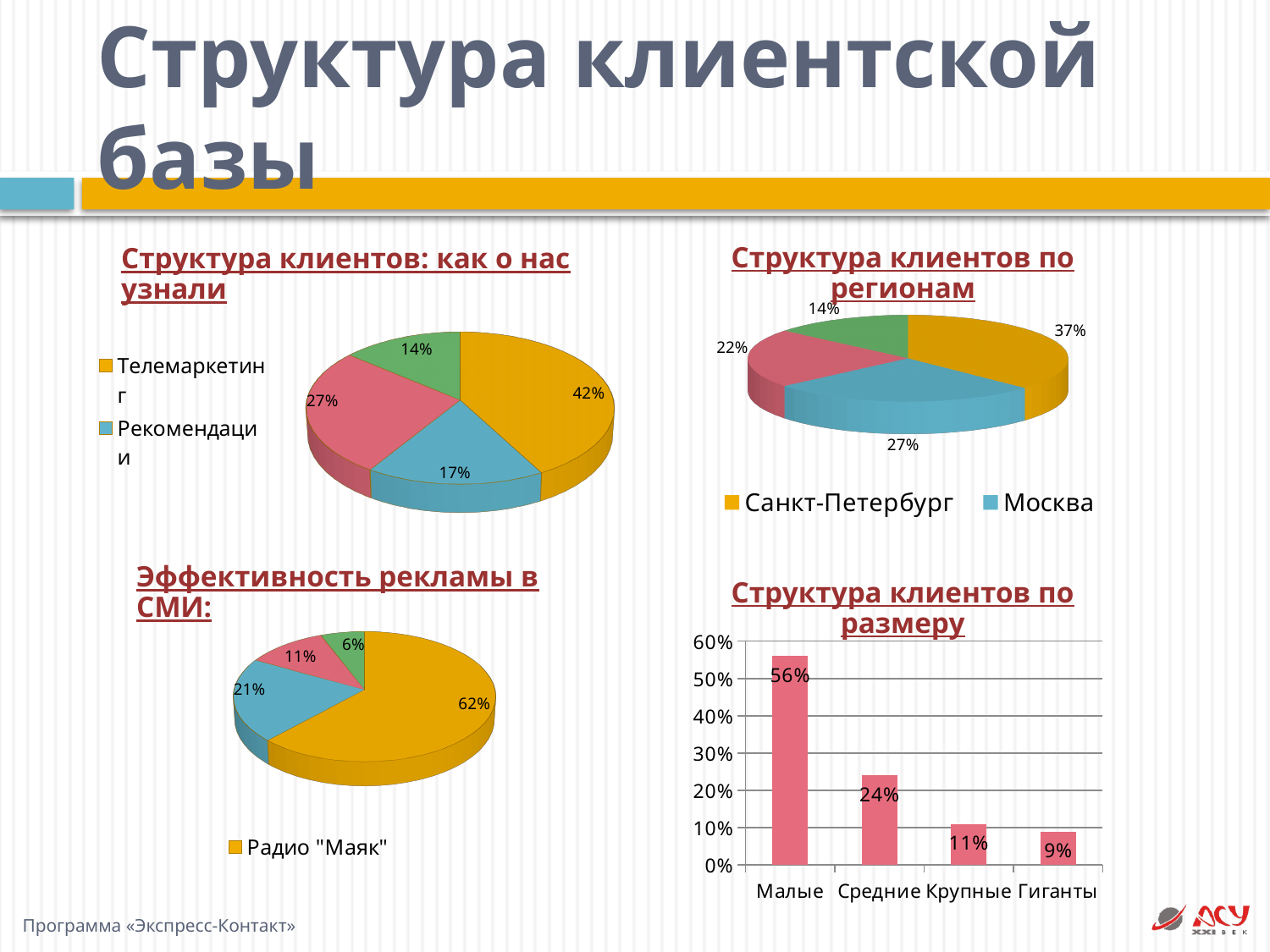
In the chart "Структура клиентов по регионам", what share of clients is from Санкт-Петербург? 37% In the chart "Структура клиентов по размеру", what is the value for Малые? 56% In the chart "Структура клиентов по размеру", which category has the lowest value? Гиганты In the chart "Эффективность рекламы в СМИ", what share does Радио "Маяк" have? 62% In the chart "Структура клиентов: как о нас узнали", what share of clients came from Рекомендации? 17% In the chart "Структура клиентов по регионам", what share of clients is from Москва? 27% What kind of chart is "Эффективность рекламы в СМИ"? Pie chart In the chart "Структура клиентов по регионам", which has the larger share, Санкт-Петербург or Москва? Санкт-Петербург In the chart "Структура клиентов: как о нас узнали", what share of clients came from Телемаркетинг? 42% In the chart "Структура клиентов по размеру", what is the difference between Средние and Крупные? 13% In the chart "Структура клиентов по размеру", how many categories are shown on the x axis? 4 In the chart "Структура клиентов: как о нас узнали", what is the difference between the Телемаркетинг share and the Рекомендации share? 25%